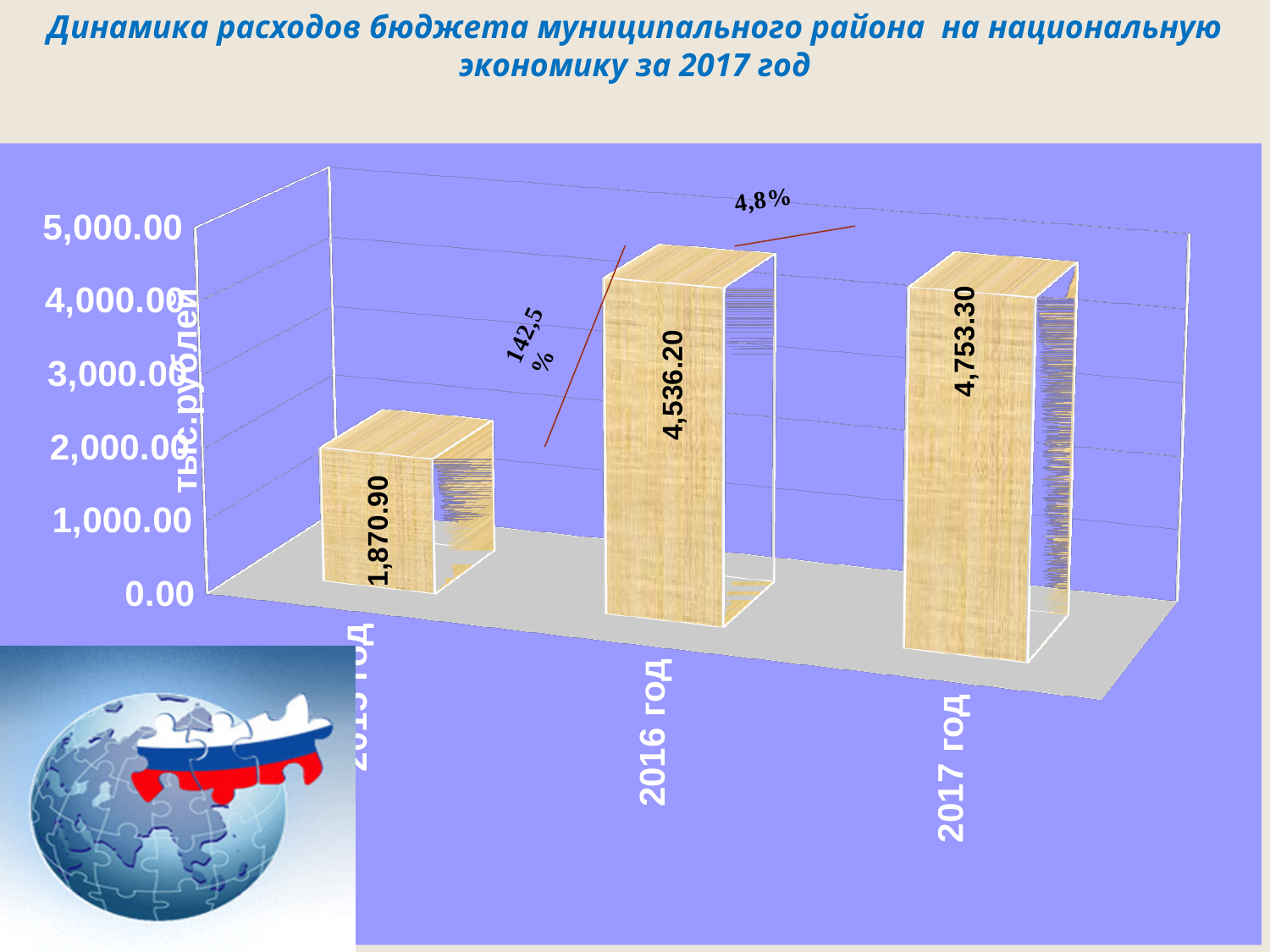
What is the difference between the value for 2016 год and the leftmost bar? 2,665.30 What is the value for 2016 год? 4,536.20 What is the value for 2017 год? 4,753.30 Which bar has the lowest value? the leftmost bar (1,870.90) What is the difference between the values for 2017 год and 2016 год? 217.10 Is the value for 2016 год greater or less than 4,000.00? greater Which year has the highest value? 2017 год What percentage change is annotated between the 2016 год and 2017 год bars? 4,8% How many bars are shown in the chart? 3 Which is larger, the value for 2016 год or 2017 год? 2017 год What kind of chart is shown on the slide? bar chart What is the value shown on the leftmost bar? 1,870.90